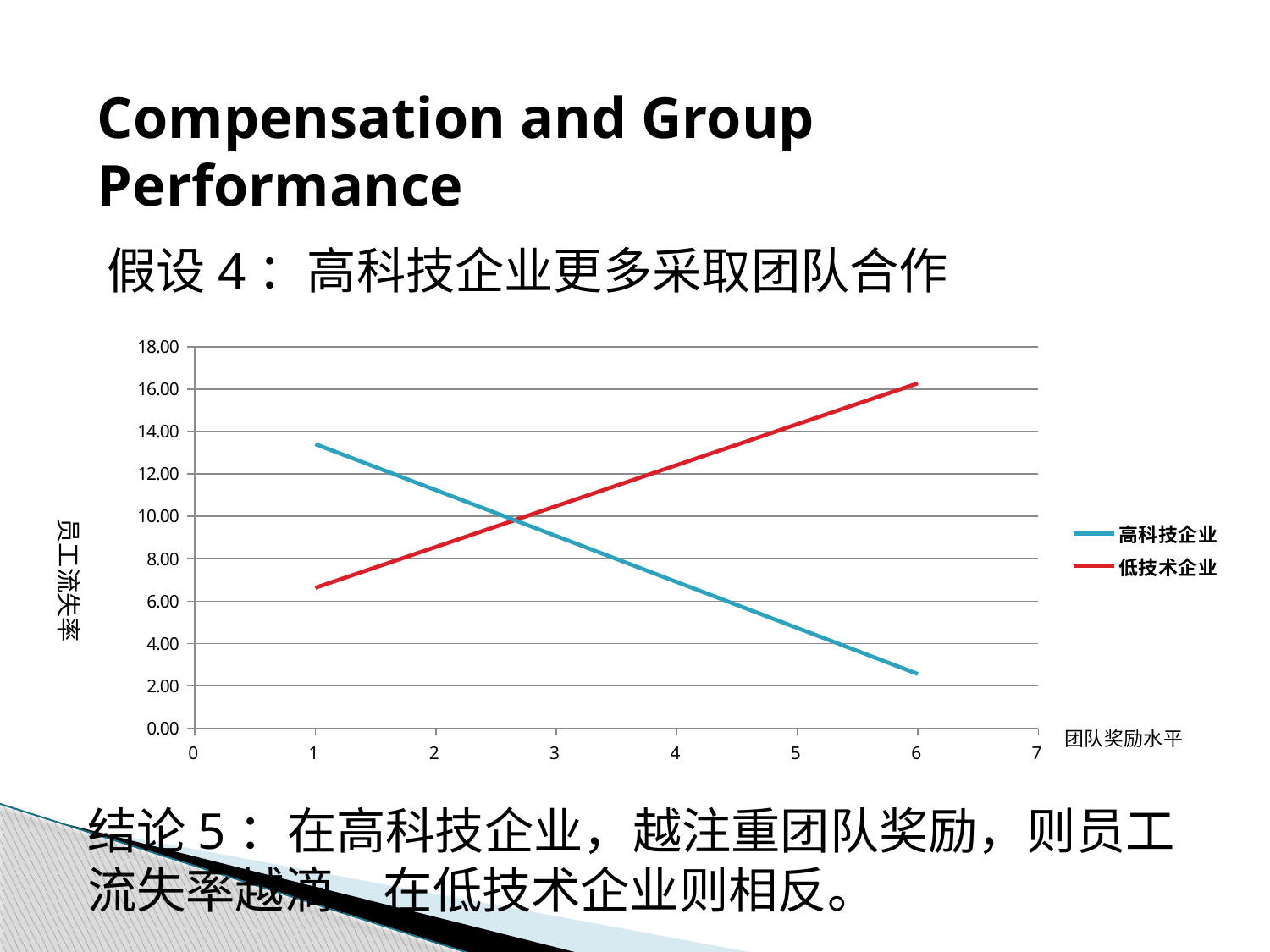
Does the 低技术企业 line rise or fall as 团队奖励水平 increases along the x axis? rise What kind of chart is shown on the slide? line chart At 团队奖励水平 = 6, which series has the higher 员工流失率, 高科技企业 or 低技术企业? 低技术企业 How many series does the legend list? 2 Is the value for 低技术企业 at 团队奖励水平 = 1 greater or less than 8.00? less At 团队奖励水平 = 1, which series has the higher 员工流失率, 高科技企业 or 低技术企业? 高科技企业 Does the 高科技企业 line rise or fall as 团队奖励水平 increases along the x axis? fall Is the value for 低技术企业 at 团队奖励水平 = 6 greater or less than 14.00? greater Is the value for 高科技企业 at 团队奖励水平 = 6 greater or less than 4.00? less What are the two series named in the legend? 高科技企业 and 低技术企业 What is the label of the vertical axis? 员工流失率